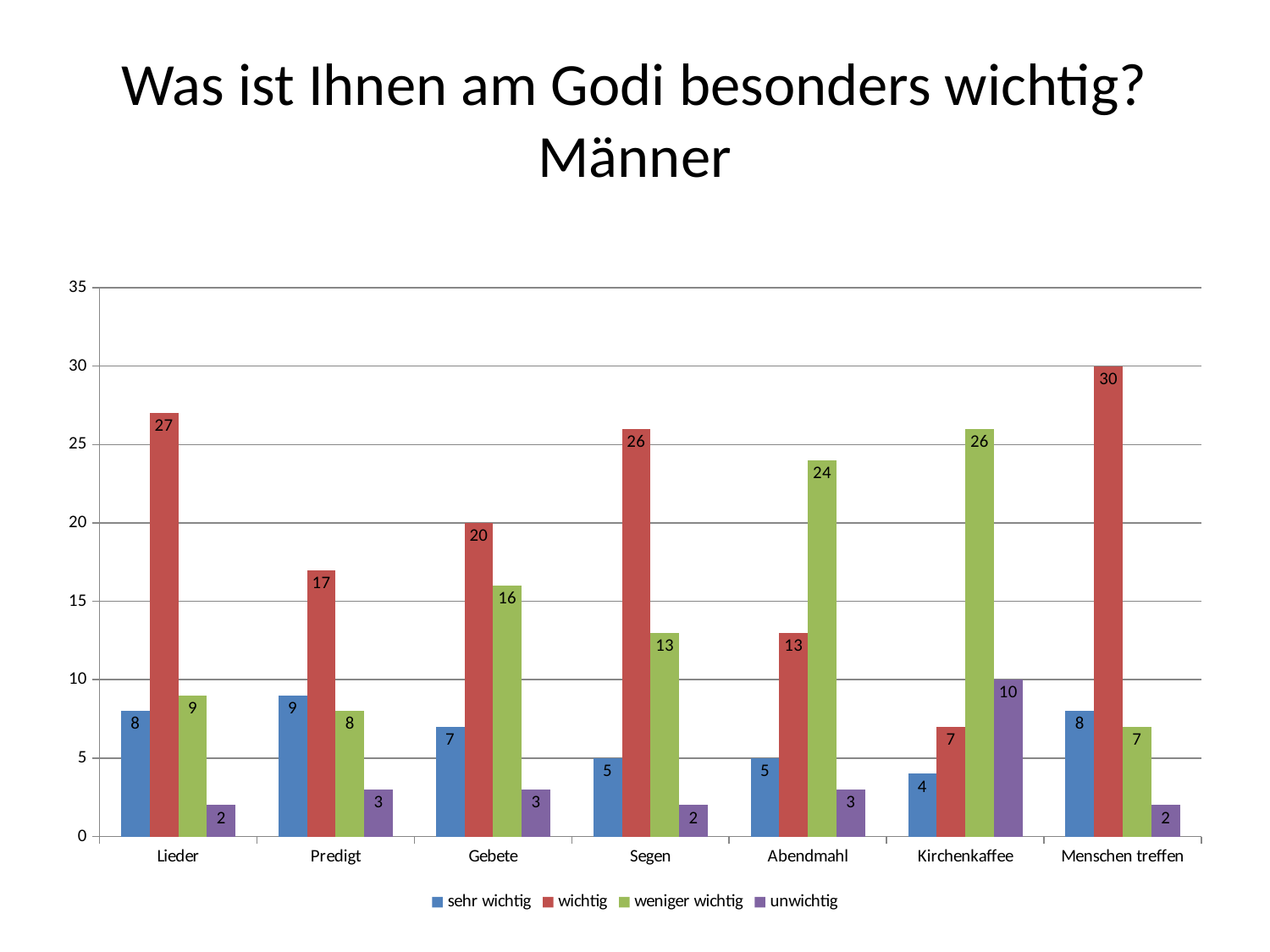
Which category has the lowest value for "sehr wichtig"? Kirchenkaffee Which is larger: "weniger wichtig" for Kirchenkaffee or "weniger wichtig" for Gebete? Kirchenkaffee Which colour represents the "unwichtig" series? purple How many categories are shown on the x axis? 7 Is the value for "wichtig" for Segen greater or less than 25? greater Which category has the highest value for "wichtig"? Menschen treffen What is the value for "wichtig" for Menschen treffen? 30 What is the value for "weniger wichtig" for Abendmahl? 24 What is the difference between the "wichtig" values for Lieder and Predigt? 10 How many series does the legend list? 4 What kind of chart is shown on the slide? bar chart What is the value for "unwichtig" for Kirchenkaffee? 10